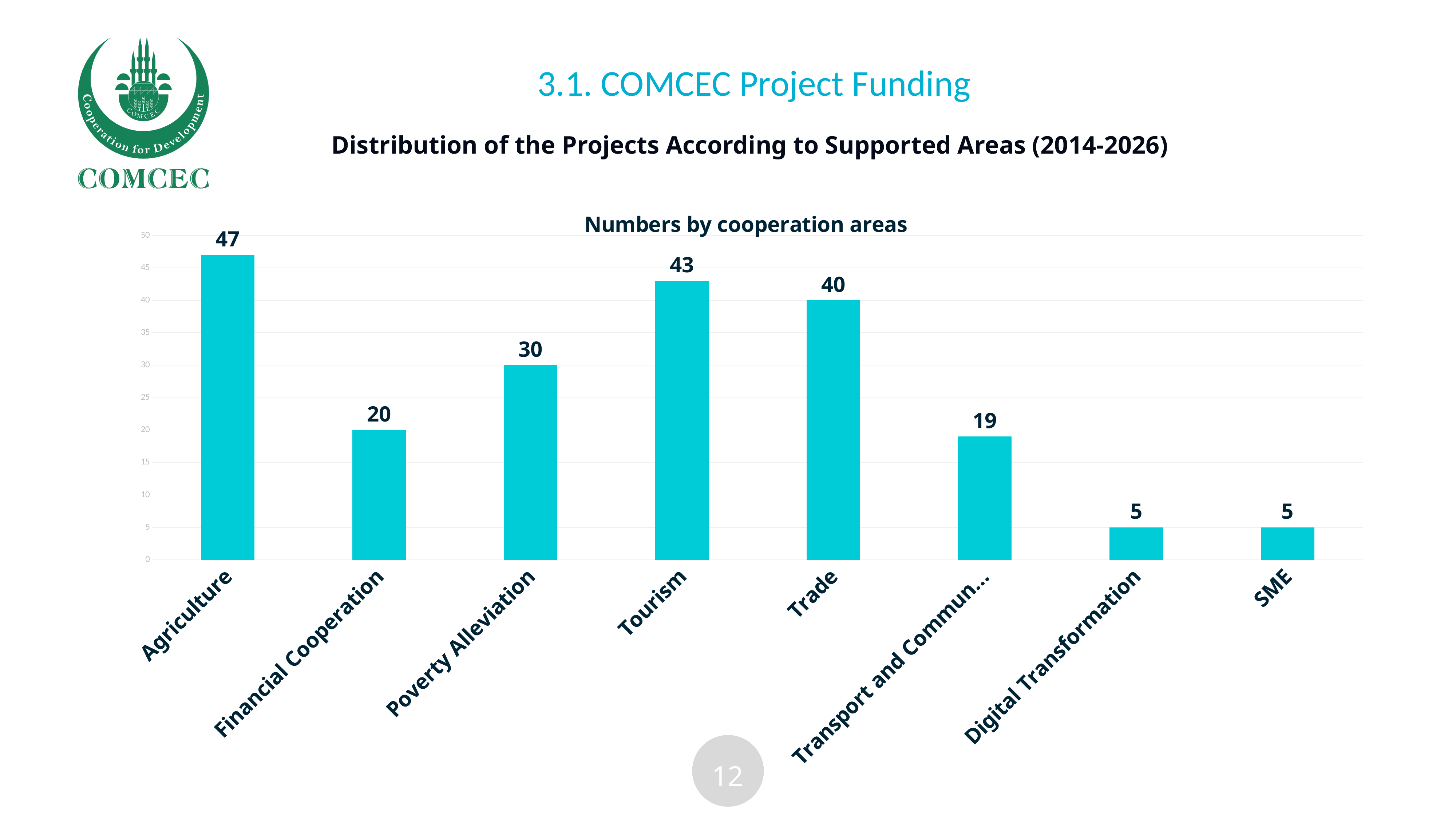
What is the difference between the values for Agriculture and Trade? 7 How many categories are shown on the x axis? 8 Which categories share the lowest value? Digital Transformation and SME What is the value for Tourism? 43 What is the value for Poverty Alleviation? 30 What is the title of the chart? Numbers by cooperation areas What kind of chart is shown on the slide? Bar chart Is the value for Trade greater or less than 35? greater What is the value for Agriculture? 47 Which is larger, the value for Tourism or the value for Trade? Tourism Which category has the highest value? Agriculture What is the value for Financial Cooperation? 20